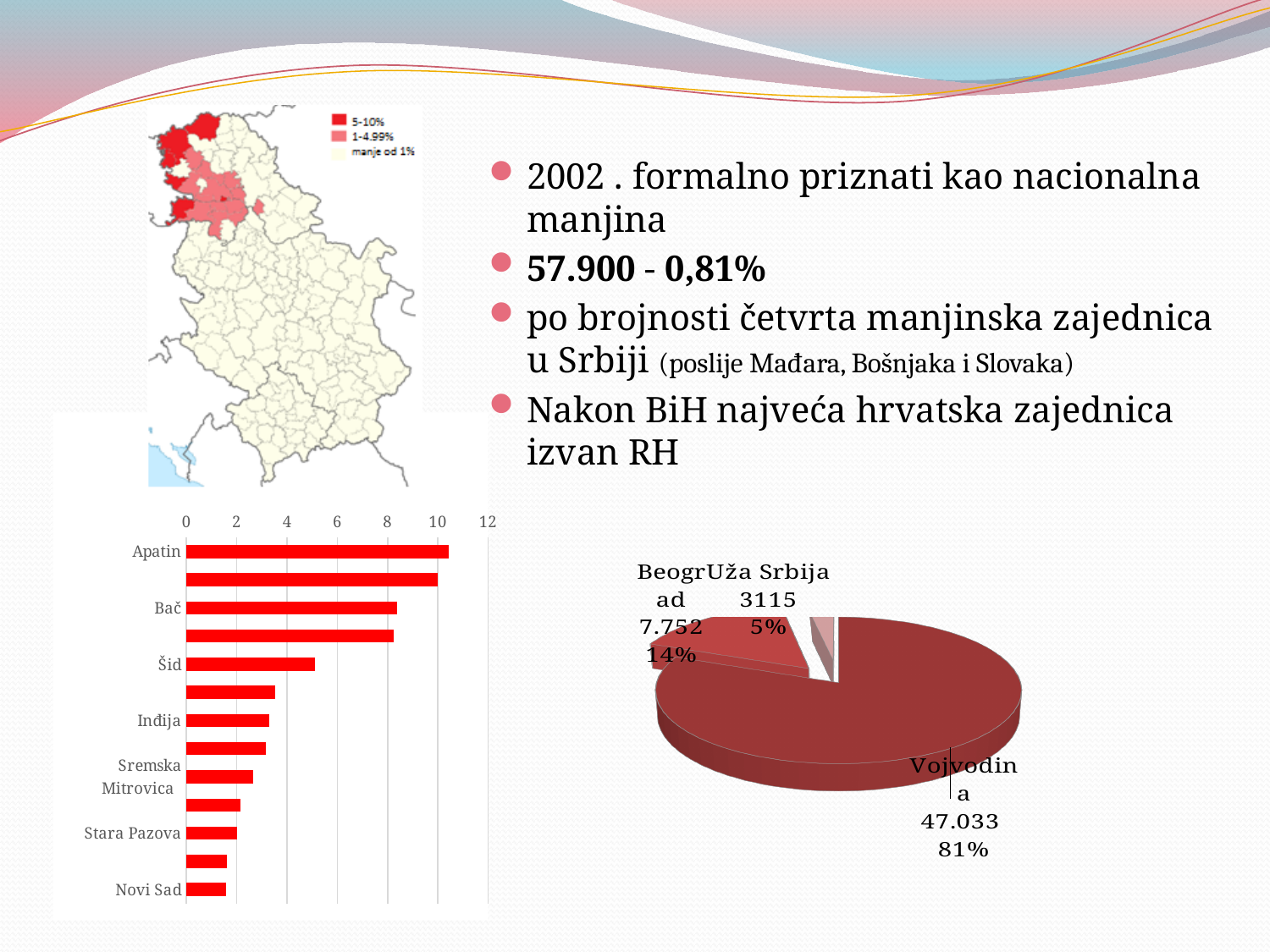
How many slices does the pie chart have? 3 In the bar chart, is the value for Šid greater or less than 6? less What kind of chart is the chart in the bottom left of the slide? bar chart In the pie chart, which slice is the largest? Vojvodina In the pie chart, what value is shown for Vojvodina? 47.033 In the pie chart, what value is shown for Beograd? 7.752 In the bar chart, which labeled category has the longest bar? Apatin In the pie chart, what is the difference between the values for Vojvodina and Beograd? 39.281 In the bar chart, which is larger, the value for Apatin or the value for Bač? Apatin In the pie chart, what percentage share does Uža Srbija have? 5% In the pie chart, which slice is the smallest? Uža Srbija In the pie chart, what percentage share does Vojvodina have? 81%